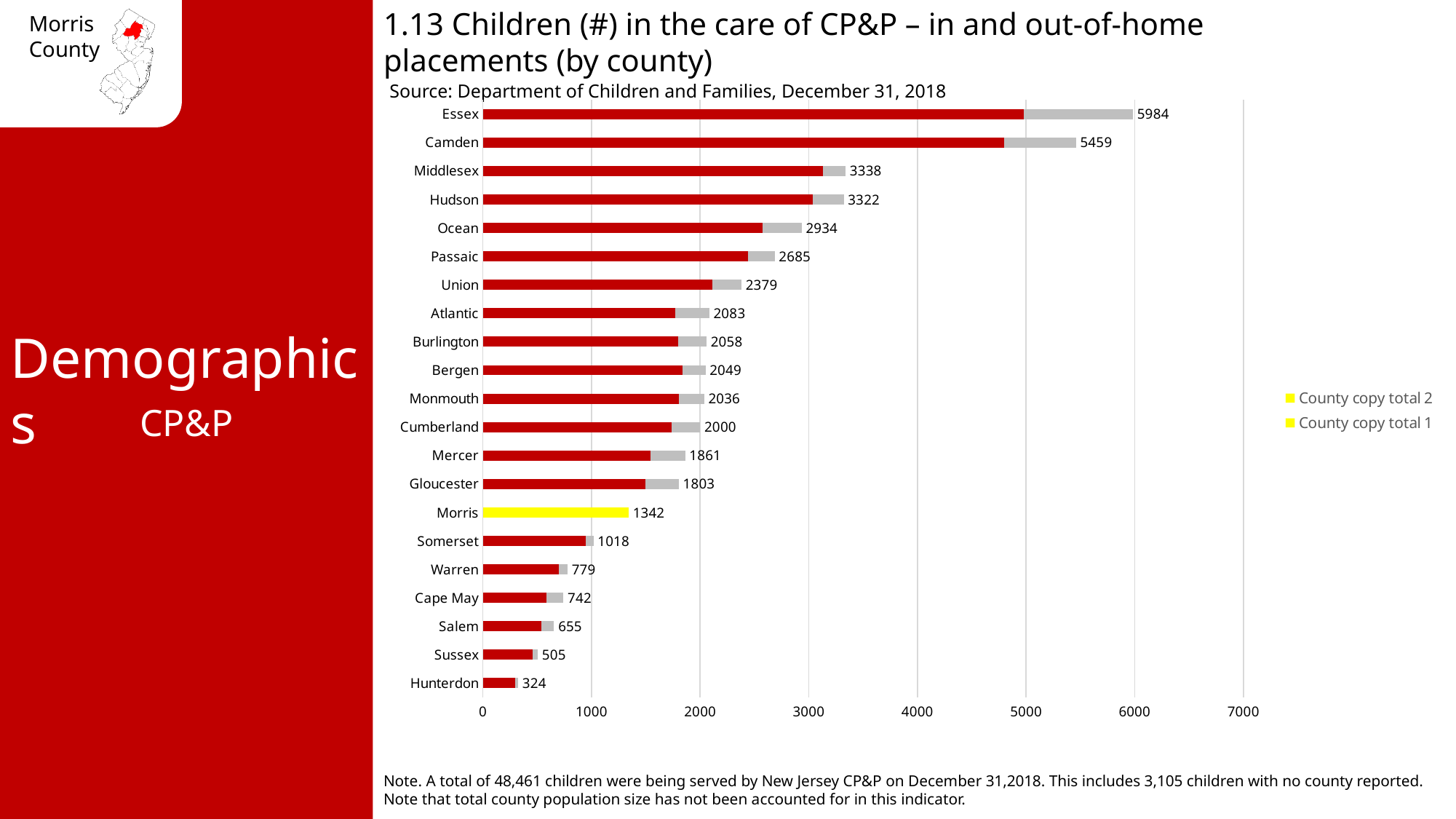
How many series does the legend list? 2 Which county has the highest total number of children in the care of CP&P? Essex What kind of chart is shown on the slide? bar chart What is the total number of children in the care of CP&P for Hunterdon? 324 What is the difference between the totals for Essex and Camden? 525 How many counties are shown in the chart? 21 Is the total for Ocean greater or less than 3000? less What is the total number of children in the care of CP&P for Morris? 1342 What is the total number of children in the care of CP&P for Essex? 5984 Which county's bar is highlighted in yellow? Morris Which county has the lowest total number of children in the care of CP&P? Hunterdon Which county has a larger total, Middlesex or Hudson? Middlesex